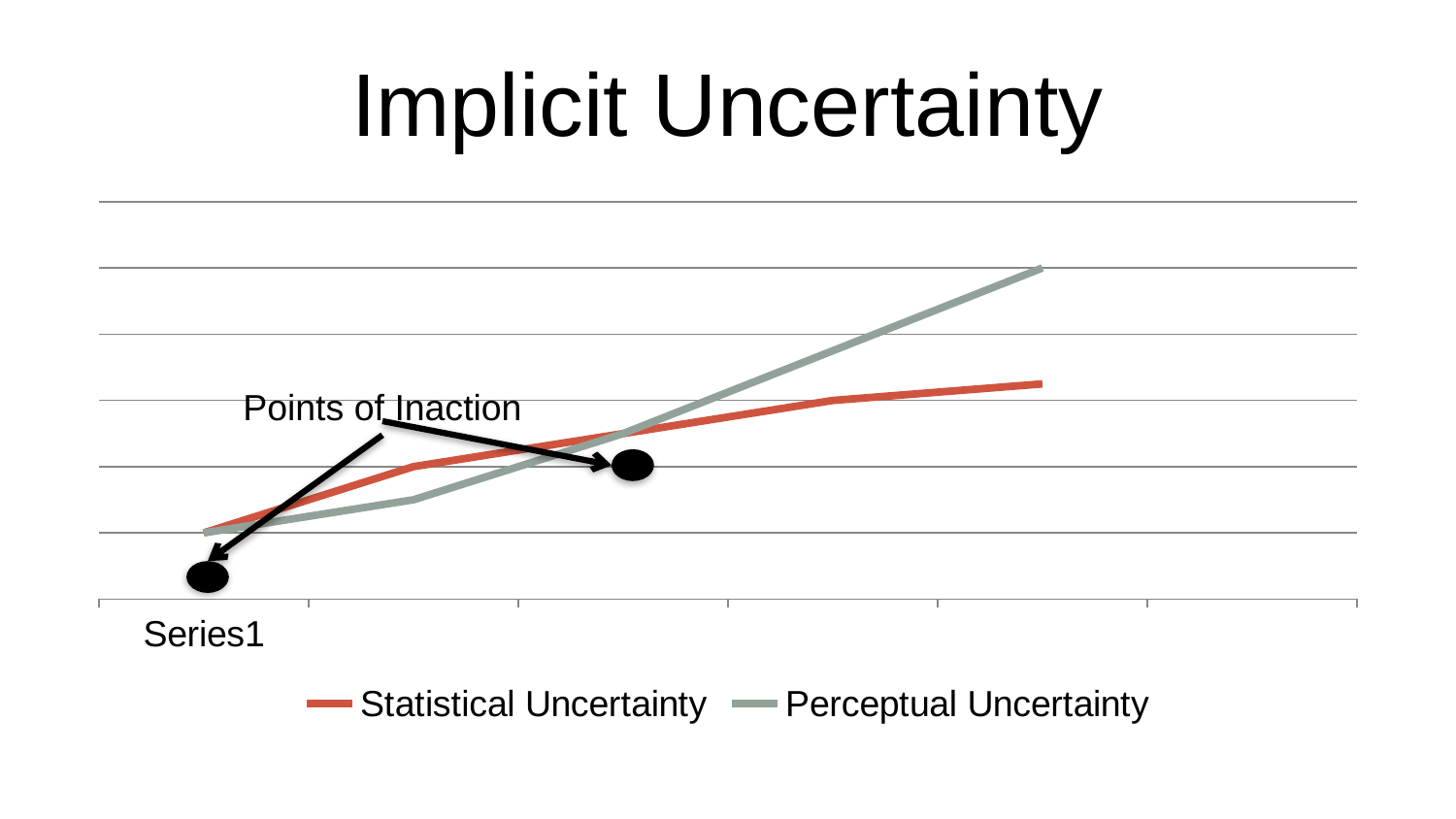
How many series does the legend list? 2 What kind of chart is shown on the slide? line chart Do the values for Perceptual Uncertainty rise or fall along the x axis? rise Which series reaches the highest value on the chart? Perceptual Uncertainty What is the title of the slide containing the chart? Implicit Uncertainty At the right end of the chart, which series has the larger value, Statistical Uncertainty or Perceptual Uncertainty? Perceptual Uncertainty Do the values for Statistical Uncertainty rise or fall along the x axis? rise Which series is drawn in red? Statistical Uncertainty